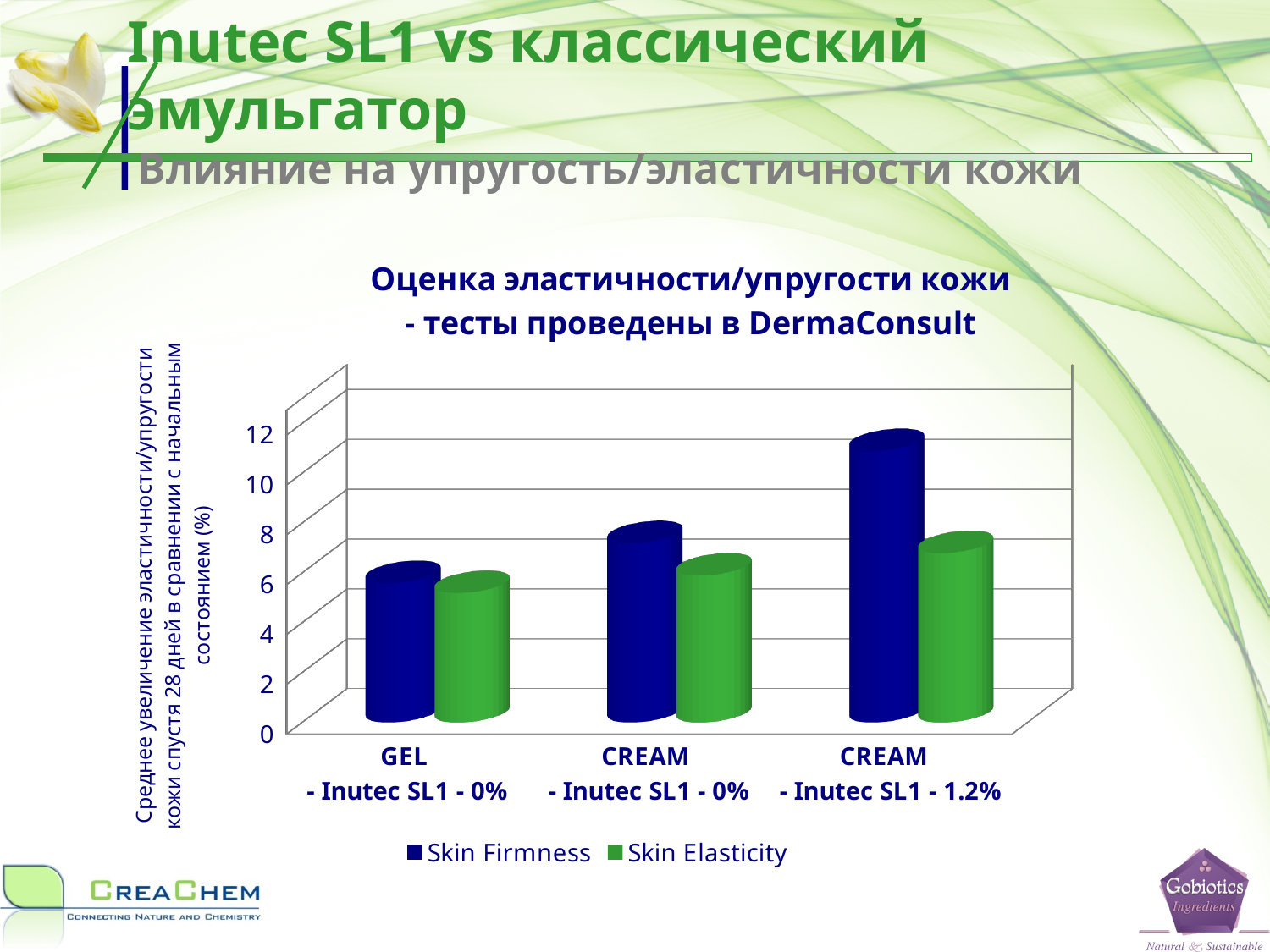
Is the Skin Firmness value for CREAM - Inutec SL1 - 1.2% greater or less than 10? greater For CREAM - Inutec SL1 - 1.2%, which is larger: Skin Firmness or Skin Elasticity? Skin Firmness Which category has the highest Skin Firmness value? CREAM - Inutec SL1 - 1.2% Which colour represents Skin Elasticity in the chart? green Is the Skin Firmness value for GEL - Inutec SL1 - 0% greater or less than 8? less Which category has the lowest Skin Firmness value? GEL - Inutec SL1 - 0% Which category has the highest Skin Elasticity value? CREAM - Inutec SL1 - 1.2% How many series does the chart legend list? 2 Do the Skin Firmness values rise or fall from left to right across the categories? rise What kind of chart is shown on the slide? bar chart How many categories are shown on the x axis of the chart? 3 Is the Skin Elasticity value for GEL - Inutec SL1 - 0% greater or less than 8? less